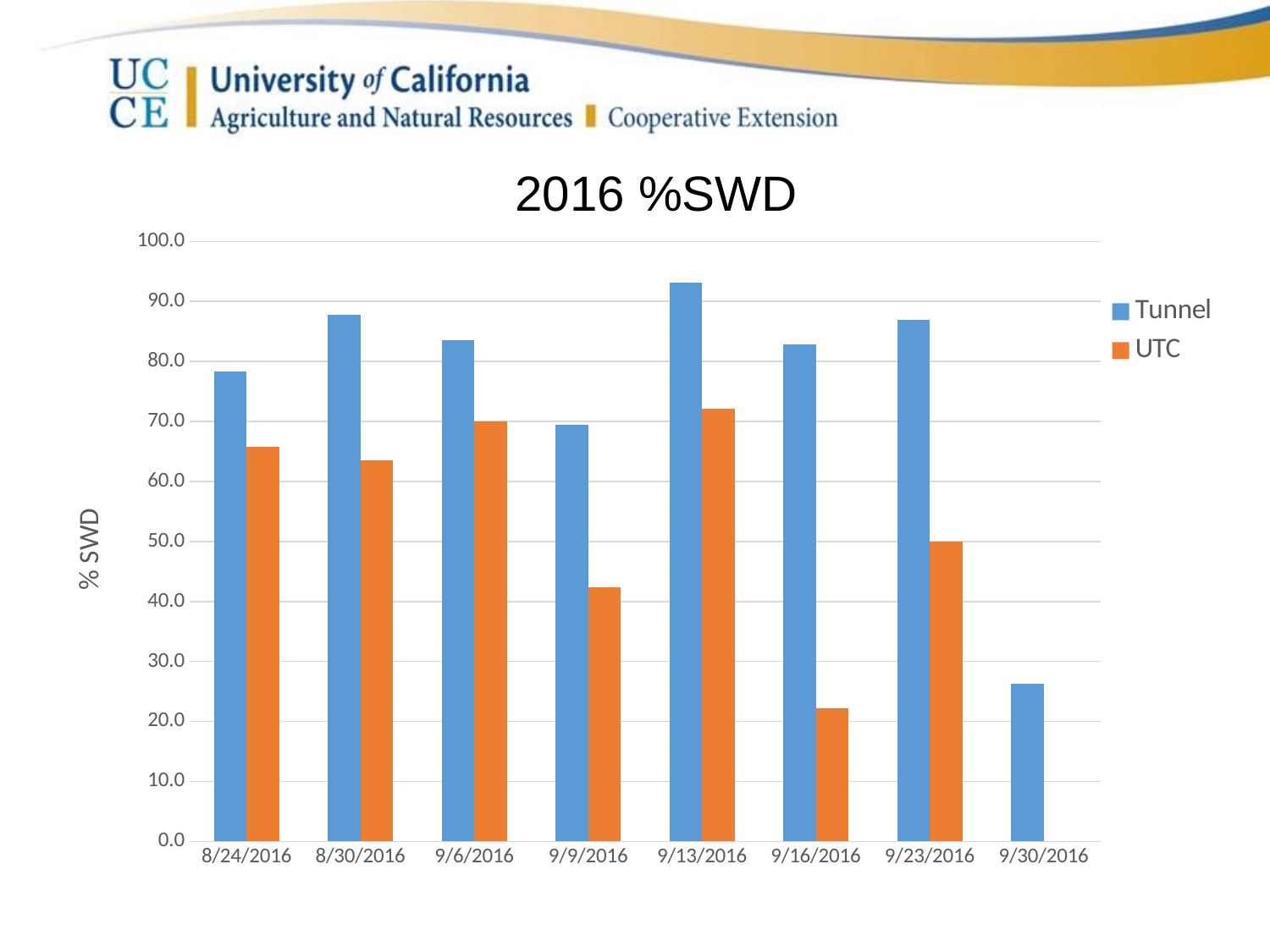
Is the Tunnel value for 9/13/2016 greater or less than 90? greater What is the label on the y axis? % SWD On which date is the Tunnel value lowest? 9/30/2016 On which date is the Tunnel value highest? 9/13/2016 How many dates are shown along the x axis? 8 Is the UTC value for 9/16/2016 greater or less than 30? less How many series does the legend list? 2 Does the Tunnel value rise or fall from 9/23/2016 to 9/30/2016? fall Is the Tunnel value for 9/30/2016 greater or less than 30? less On 9/9/2016, which is larger, Tunnel or UTC? Tunnel What kind of chart is shown on the slide? bar chart